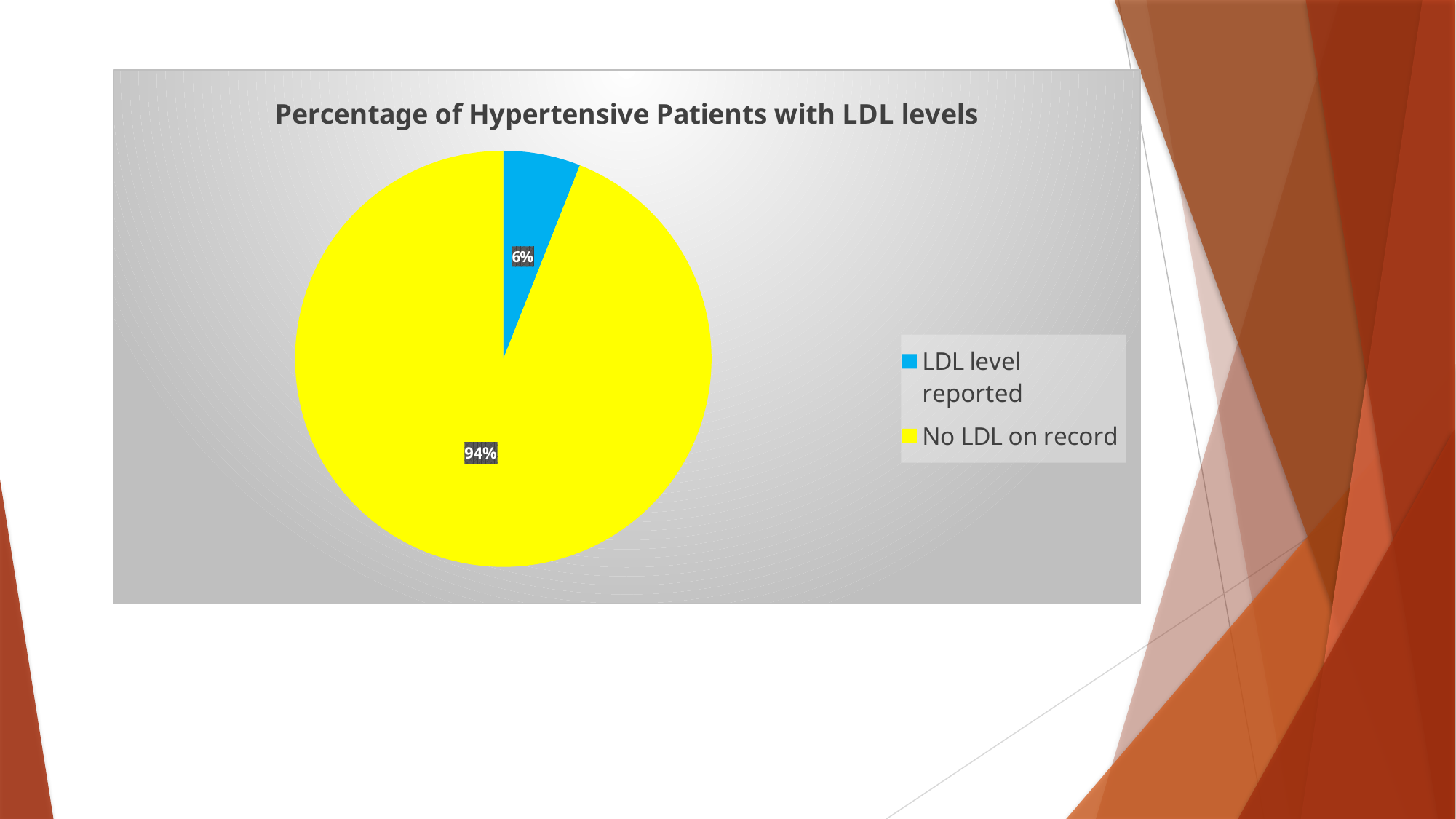
What percentage of hypertensive patients had an LDL level reported? 6% What type of chart is shown on the slide? pie chart What percentage of hypertensive patients had no LDL on record? 94% What is the title of the chart? Percentage of Hypertensive Patients with LDL levels What colour represents 'No LDL on record' in the pie chart? yellow Which category has the smallest share of the pie? LDL level reported What is the difference in percentage points between 'No LDL on record' and 'LDL level reported'? 88 How many categories does the pie chart show? 2 What share of the pie does the 'LDL level reported' slice represent? 6% How many entries does the legend list? 2 Which is larger: the share for 'LDL level reported' or the share for 'No LDL on record'? No LDL on record Which category has the largest share of the pie? No LDL on record